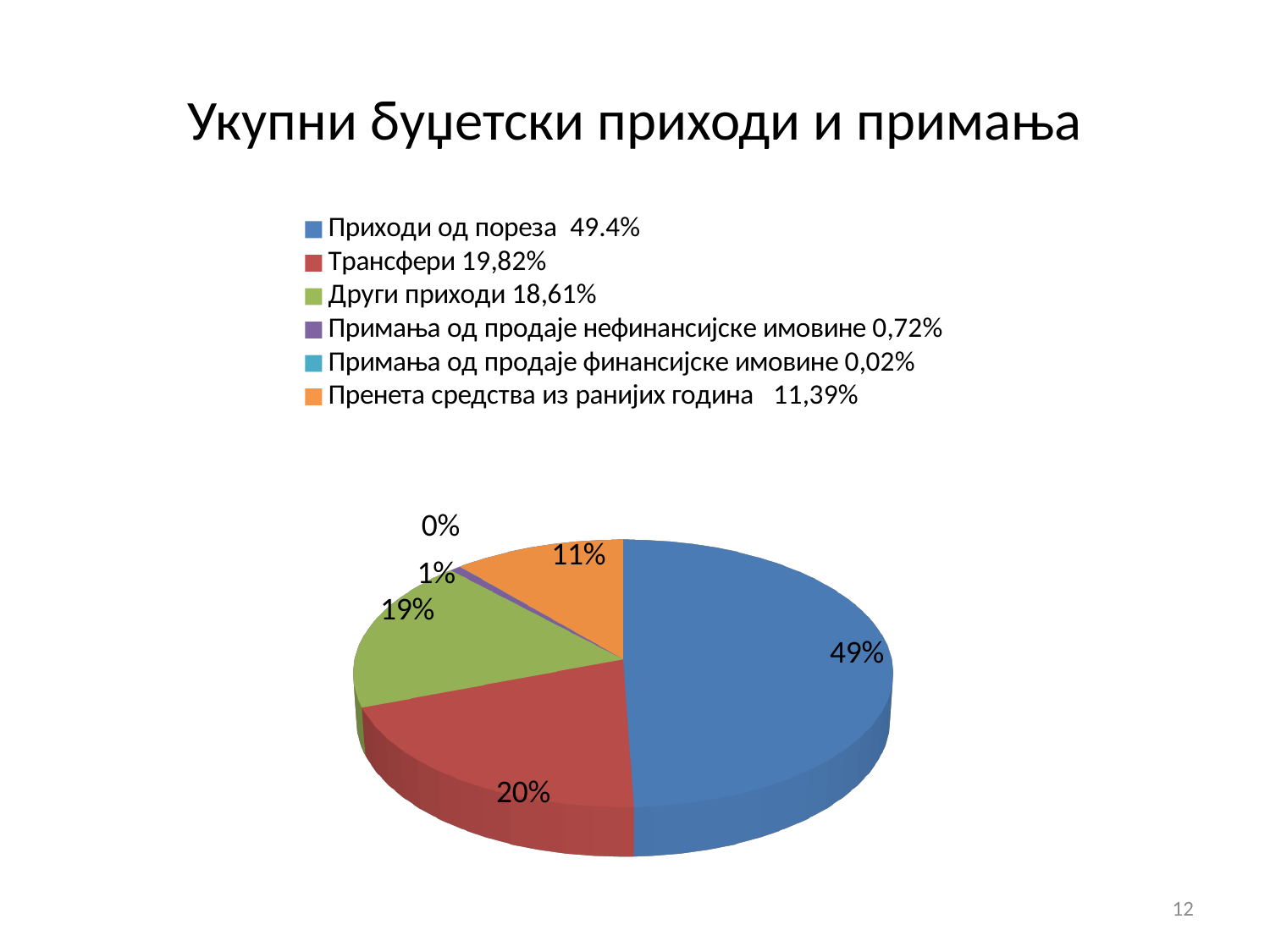
Which is larger, the share for Трансфери or the share for Други приходи? Трансфери What kind of chart is shown on the slide? pie chart What percentage does the legend give for Примања од продаје нефинансијске имовине? 0,72% Which category has the largest slice of the pie? Приходи од пореза Using the labels on the pie, what is the difference between the Приходи од пореза slice and the Трансфери slice? 29 percentage points What percentage does the legend give for Други приходи? 18,61% How many categories does the pie chart have? 6 Which category has the smallest slice of the pie? Примања од продаје финансијске имовине What percentage label is shown on the pie slice for Пренета средства из ранијих година? 11% What percentage label is shown on the pie slice for Трансфери? 20% What is the title of the slide? Укупни буџетски приходи и примања What colour is the slice for Приходи од пореза? blue